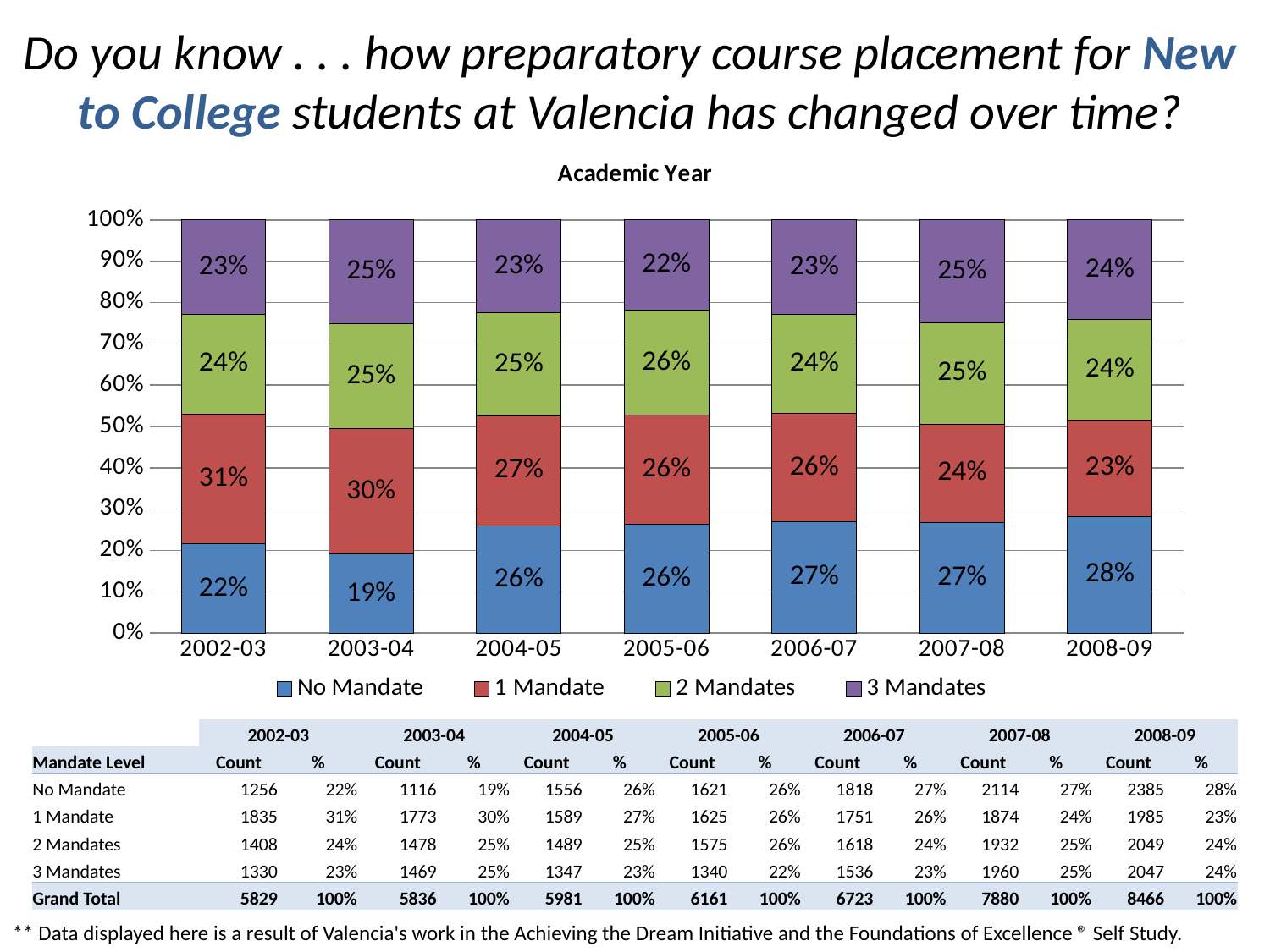
What is the value for 2 Mandates in 2007-08? 25% What percentage of students had 1 Mandate in 2003-04? 30% What is the difference between the 1 Mandate share in 2002-03 and in 2008-09? 8 percentage points How many series does the chart legend list? 4 What is the value for 3 Mandates in 2005-06? 22% How many academic years are shown on the x axis of the chart? 7 What percentage of New to College students had No Mandate in 2002-03? 22% In which academic year was the No Mandate share the lowest? 2003-04 Which is larger: the No Mandate share in 2004-05 or the 3 Mandates share in 2004-05? No Mandate (26%) What type of chart is shown on the slide? Stacked bar chart In which academic year was the No Mandate share the highest? 2008-09 Does the 1 Mandate share generally rise or fall from 2002-03 to 2008-09? Fall